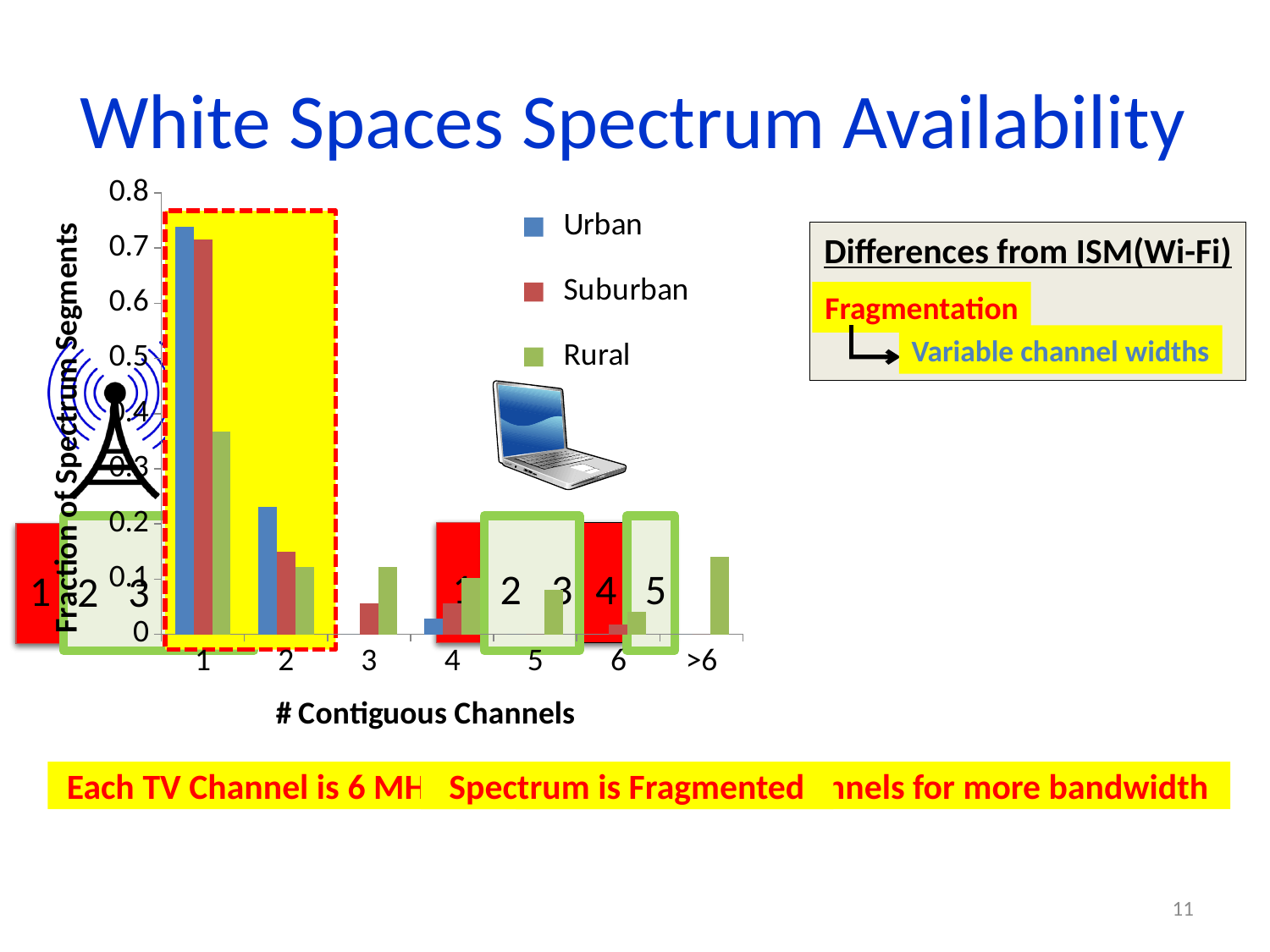
How many series does the chart's legend list? 3 Is the Rural value for >6 contiguous channels greater or less than 0.2? less Is the Urban value for 1 contiguous channel greater or less than 0.7? greater For 2 contiguous channels, which is larger: the Urban value or the Rural value? Urban How many categories are shown on the x axis of the chart? 7 Is the Rural value for 1 contiguous channel greater or less than 0.4? less Do the Urban values rise or fall from 1 to 3 contiguous channels? fall What kind of chart is shown on the slide? bar chart Which series has the lowest value for 1 contiguous channel? Rural What is the title of the chart's x axis? # Contiguous Channels For which number of contiguous channels is the Urban value highest? 1